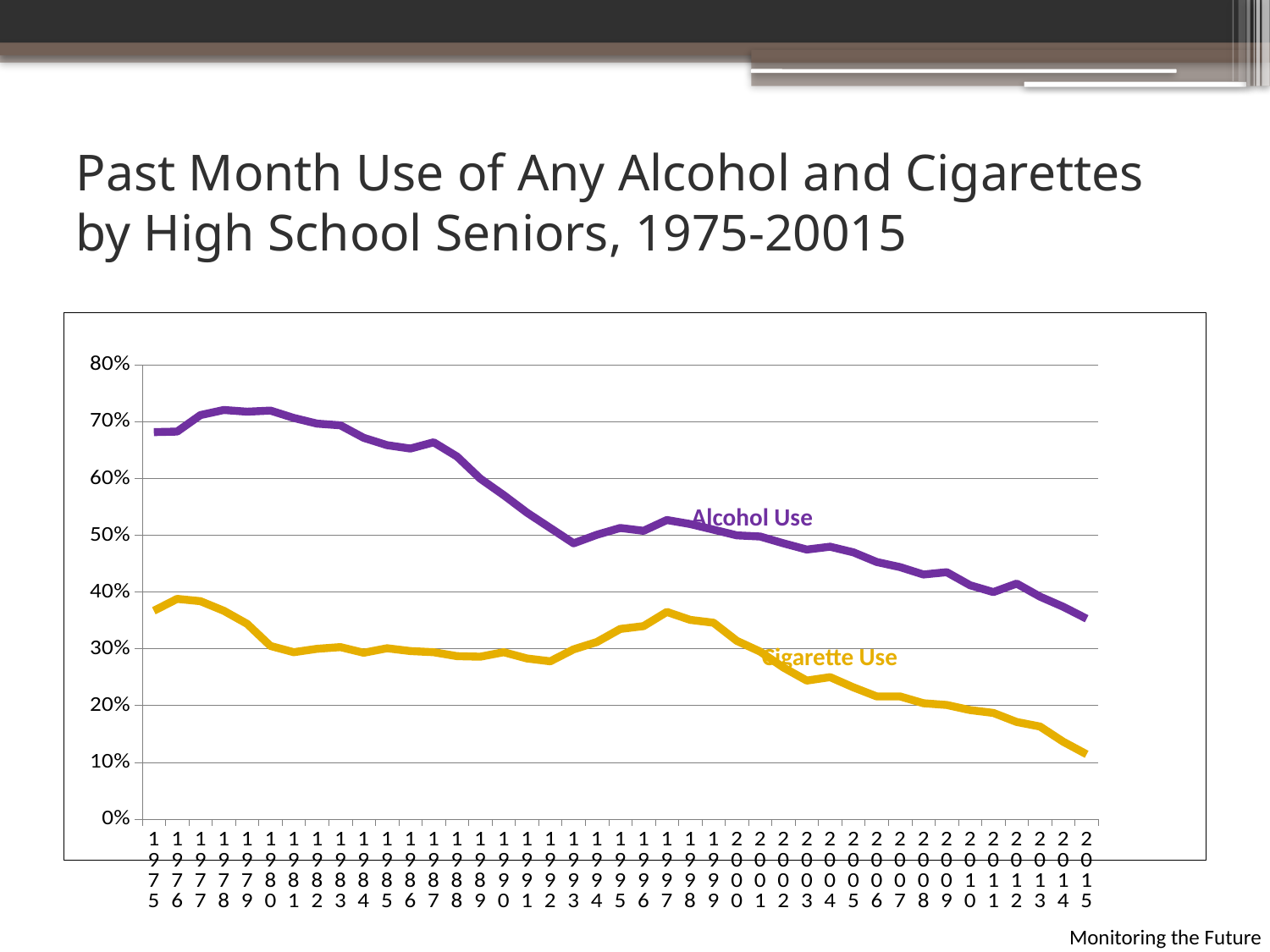
Which series is higher in 1975, Alcohol Use or Cigarette Use? Alcohol Use Is the value for Alcohol Use in 1975 greater or less than 60%? greater How many years (data points) does the x axis cover? 41 Is the value for Cigarette Use in 2015 greater or less than 20%? less What colour is the Cigarette Use line? yellow Does Alcohol Use generally rise or fall from 1975 to 2015? fall In which year is Cigarette Use at its lowest? 2015 Is the value for Cigarette Use in 1975 greater or less than 30%? greater In which year is Alcohol Use at its lowest? 2015 How many data series are plotted on the chart? 2 What kind of chart is shown on the slide? line chart